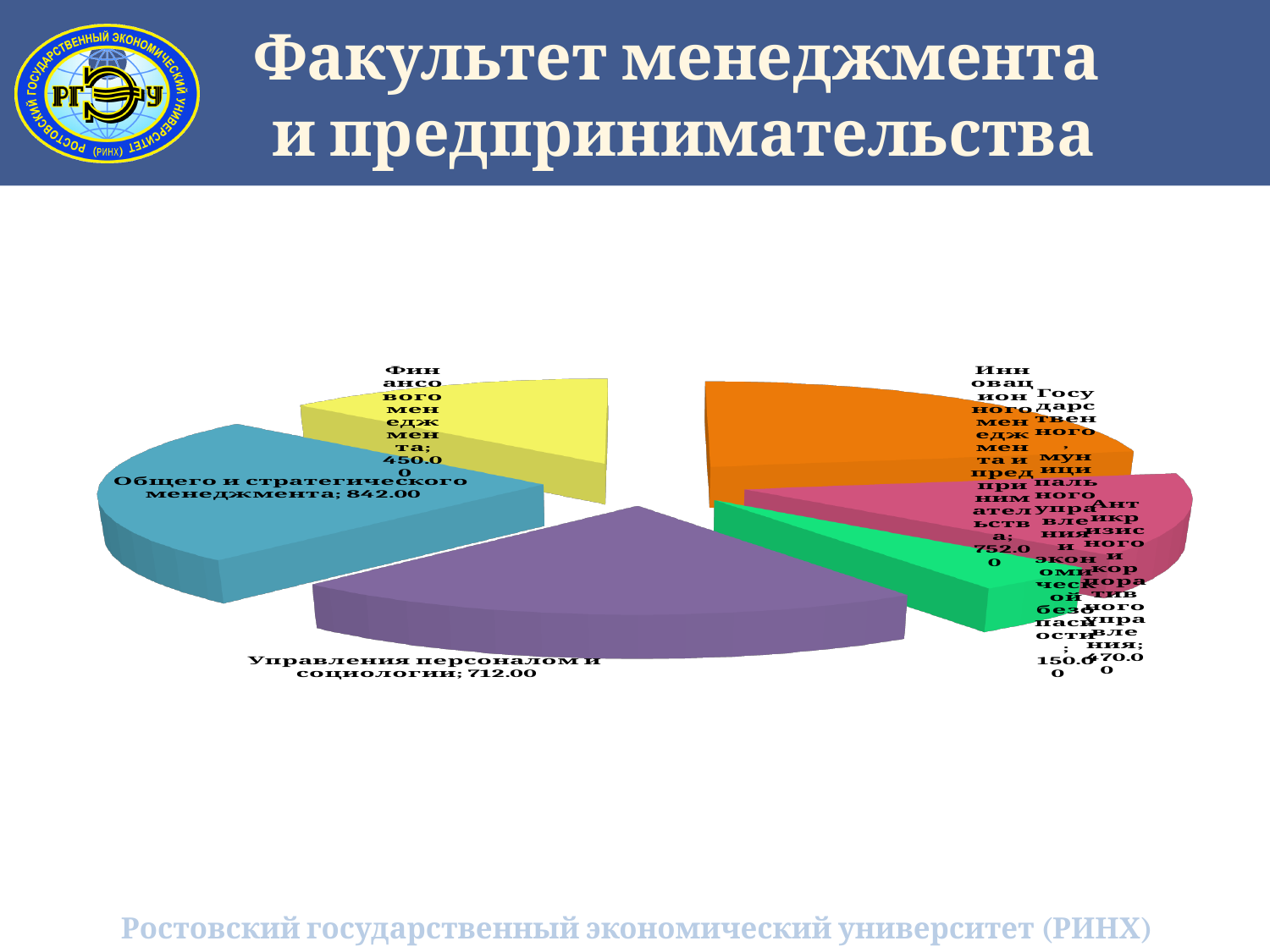
What is the value for Инновационного менеджмента и предпринимательства? 752.00 Which is larger: the value for Инновационного менеджмента и предпринимательства or the value for Управления персоналом и социологии? Инновационного менеджмента и предпринимательства What colour is the slice for Управления персоналом и социологии? Purple What is the value for Финансового менеджмента? 450.00 What is the value for Управления персоналом и социологии? 712.00 What is the difference between the values for Общего и стратегического менеджмента and Управления персоналом и социологии? 130.00 Which category has the largest slice of the pie? Общего и стратегического менеджмента What is the value for Антикризисного и корпоративного управления? 470.00 Which category has the smallest slice of the pie? Государственного, муниципального управления и экономической безопасности What is the value for Общего и стратегического менеджмента? 842.00 What kind of chart is shown on the slide? Pie chart How many slices does the pie chart have? 6